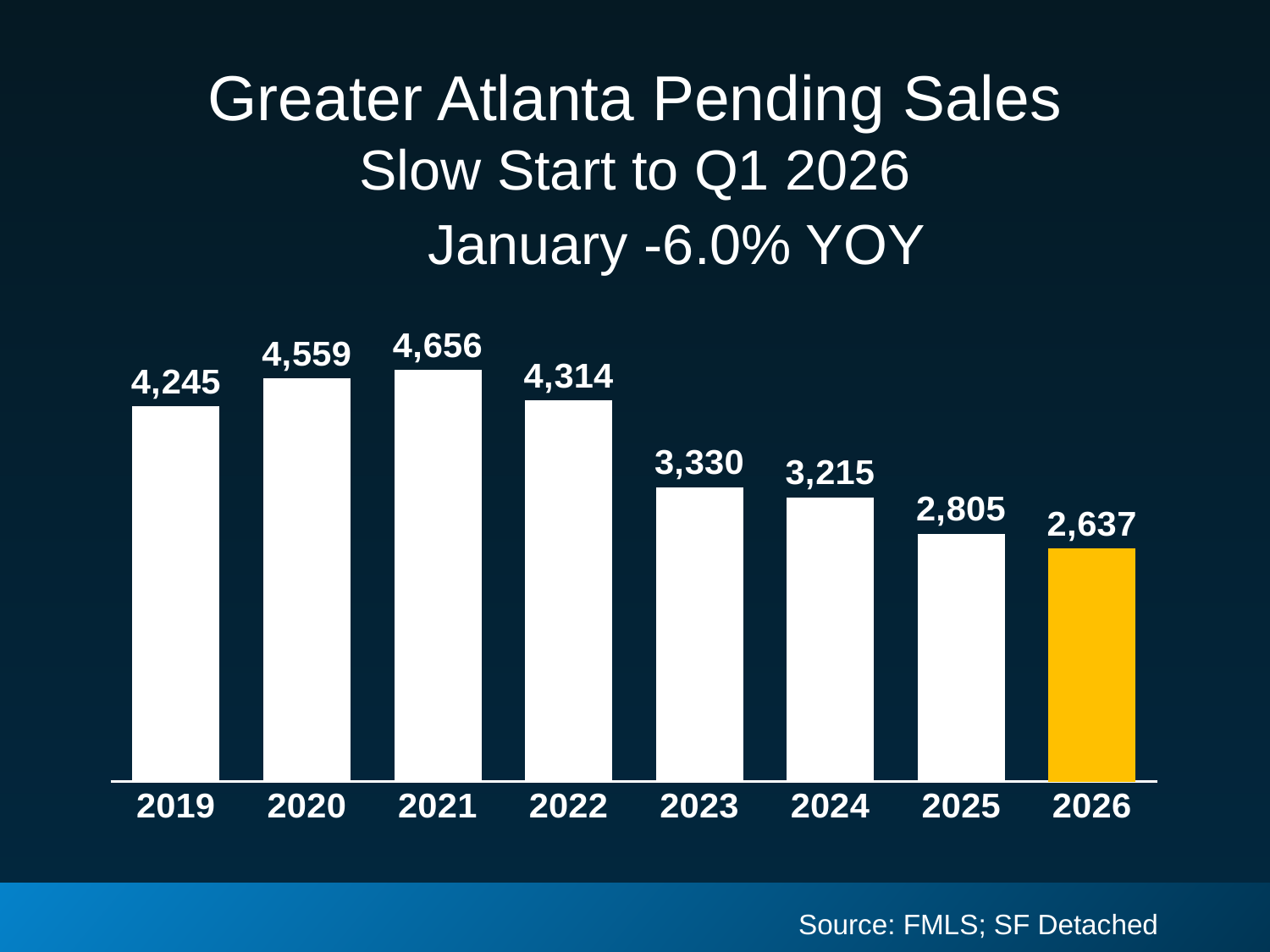
What is the difference between the values for 2025 and 2026? 168 Which is larger, the value for 2020 or the value for 2022? 2020 Do the values rise or fall from 2021 to 2026? Fall What kind of chart is this? Bar chart What is the value for 2019? 4,245 What is the difference between the values for 2021 and 2022? 342 What is the value for 2026? 2,637 Which bar is coloured differently from the others? 2026 What is the value for 2023? 3,330 How many years are shown on the x axis? 8 Which year has the lowest value? 2026 Which year has the highest value? 2021